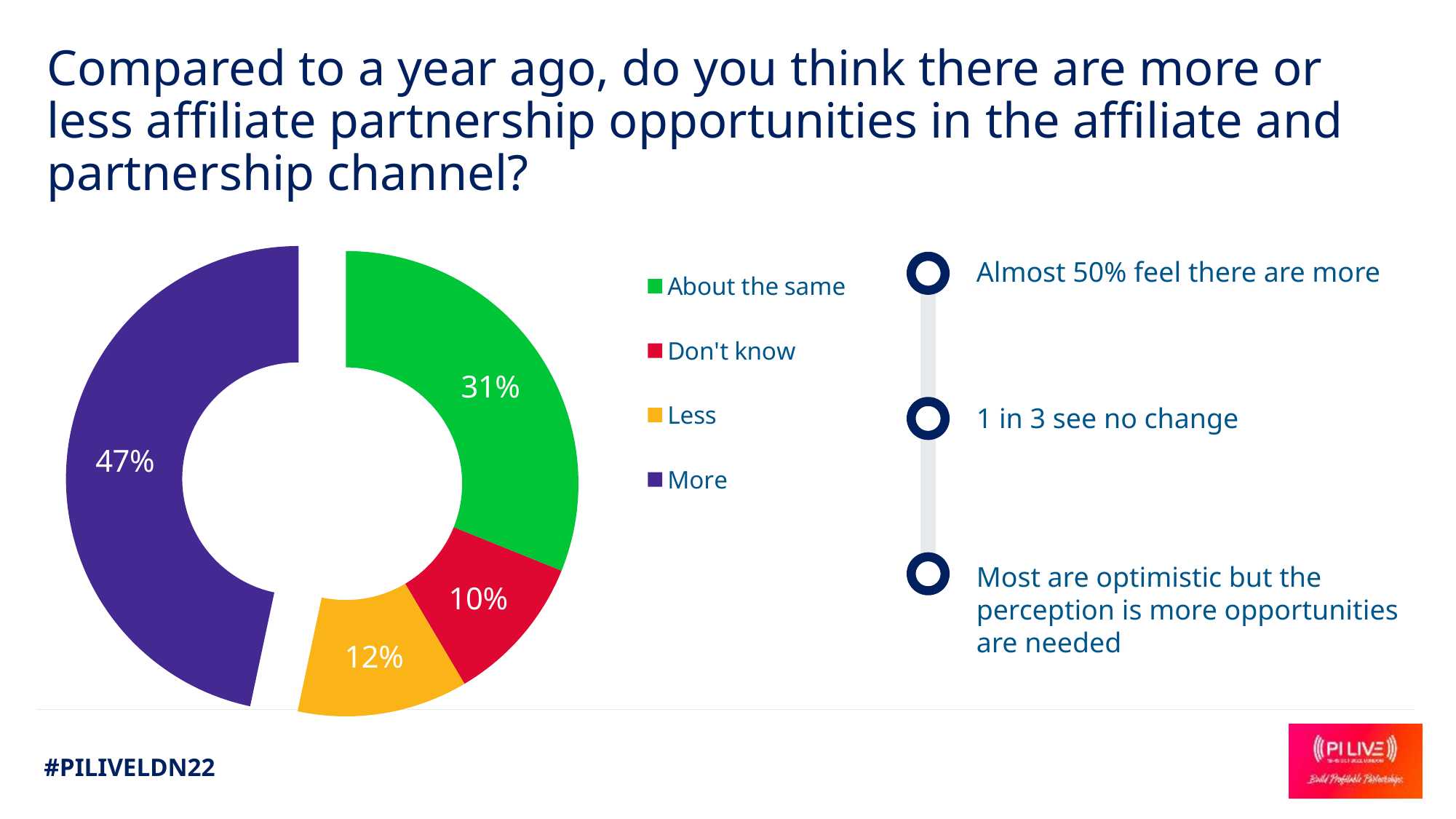
What kind of chart is shown on the slide? Pie chart (doughnut) What percentage of respondents answered "Less"? 12% How many response categories does the chart show? 4 What colour represents "About the same" in the chart? Green What percentage of respondents answered "Don't know"? 10% Which response has the smallest share of the chart? Don't know Which is larger, the share for "Less" or the share for "Don't know"? Less What is the difference in percentage points between "More" and "About the same"? 16 What is the combined share of "Less" and "Don't know"? 22% What percentage of respondents answered "About the same"? 31% Which response has the largest share of the chart? More What percentage of respondents answered "More"? 47%